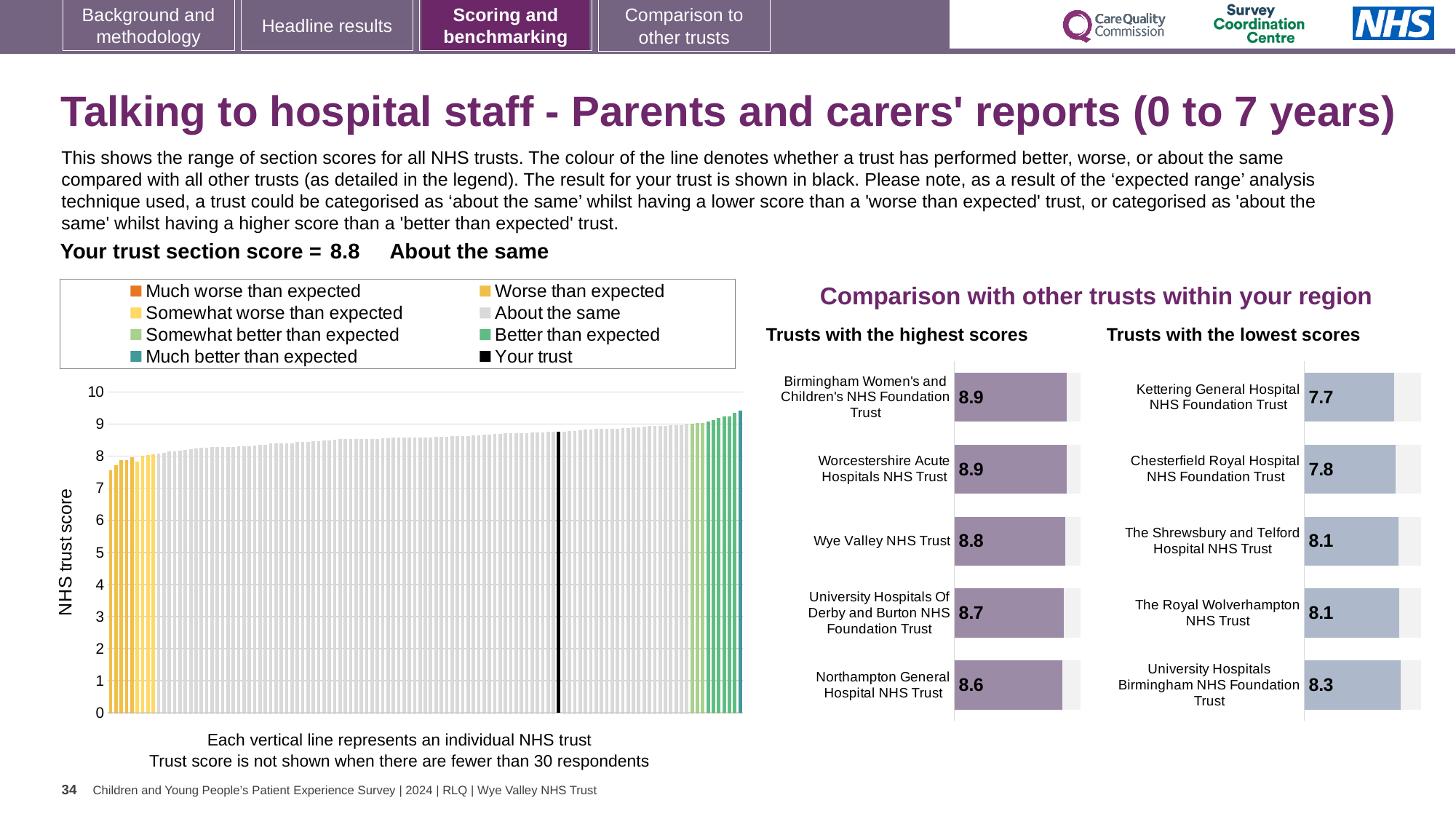
In the large chart on the left, is the value for the black bar (your trust) greater or less than 8? greater In the 'Trusts with the highest scores' chart, what is the score for Northampton General Hospital NHS Trust? 8.6 In the 'Trusts with the highest scores' chart, which trust has the lowest score? Northampton General Hospital NHS Trust How many trusts are shown in the 'Trusts with the lowest scores' chart? 5 In the 'Trusts with the highest scores' chart, what is the score for Wye Valley NHS Trust? 8.8 In the 'Trusts with the highest scores' chart, which has the larger score: Wye Valley NHS Trust or Northampton General Hospital NHS Trust? Wye Valley NHS Trust In the 'Trusts with the lowest scores' chart, which trust has the highest score? University Hospitals Birmingham NHS Foundation Trust How many entries does the legend of the large chart on the left list? 8 In the 'Trusts with the lowest scores' chart, what is the score for Kettering General Hospital NHS Foundation Trust? 7.7 In the large chart on the left, do the bar values rise or fall from left to right? rise In the 'Trusts with the lowest scores' chart, which trust has the lowest score? Kettering General Hospital NHS Foundation Trust In the 'Trusts with the lowest scores' chart, what is the difference between the scores of University Hospitals Birmingham NHS Foundation Trust and Kettering General Hospital NHS Foundation Trust? 0.6